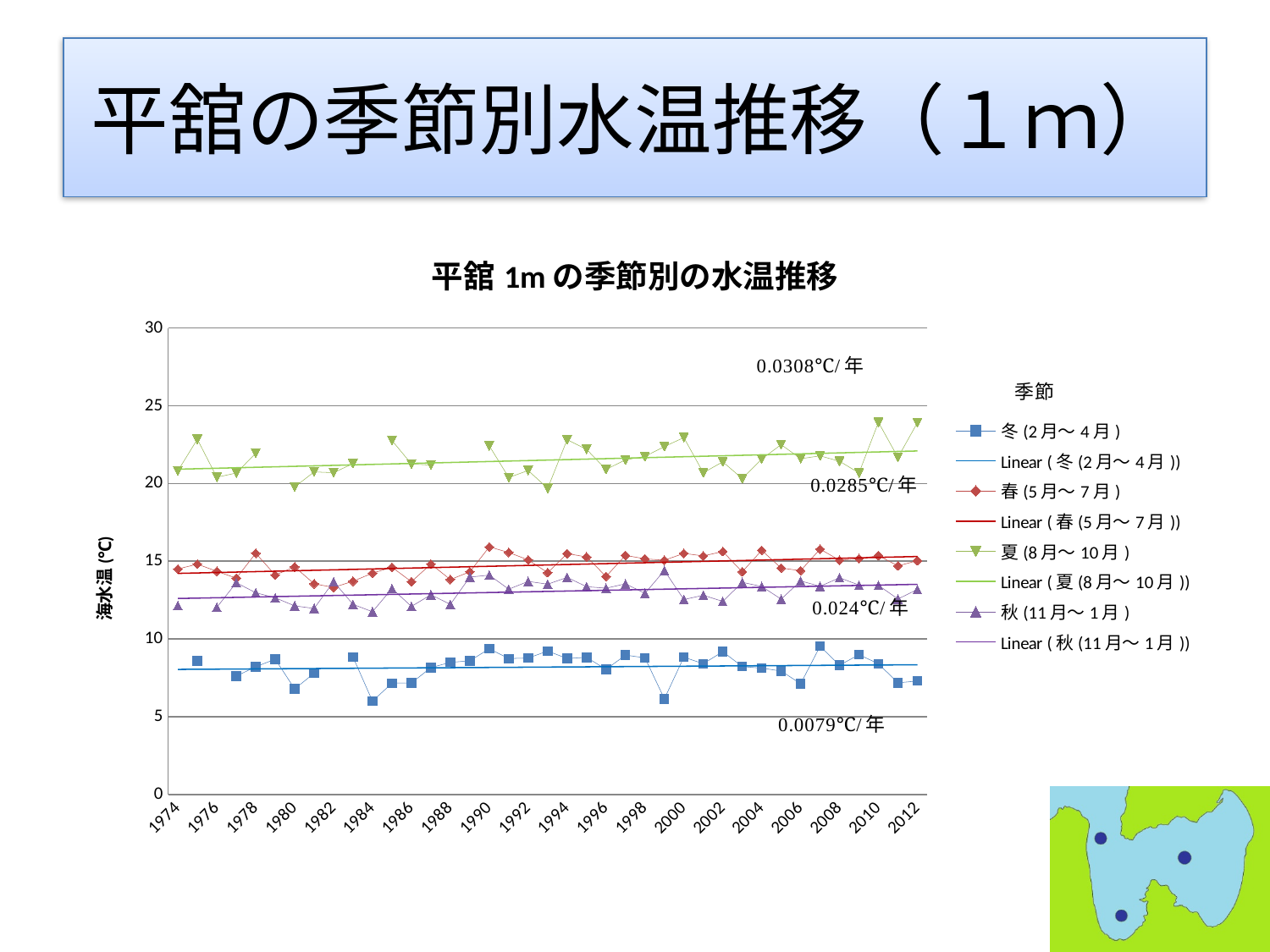
Is the winter (冬) value for 1984 greater or less than 10? less Do the summer (夏) values rise or fall along the x axis according to the trend line? rise What kind of chart is shown on the slide? line chart What annual rate of change is printed next to the summer (夏) trend line? 0.0308℃/年 What annual rate of change is printed next to the spring (春) trend line? 0.0285℃/年 Which season series has the highest water temperatures across the chart? 夏 (8月～10月) Is the summer (夏) value for 2010 greater or less than 20? greater What is the title of the chart? 平舘 1m の季節別の水温推移 What is the label of the vertical axis? 海水温 (℃) What annual rate of change is printed next to the winter (冬) trend line? 0.0079℃/年 How many entries does the chart legend list? 8 Which season series has the lowest water temperatures across the chart? 冬 (2月～4月)